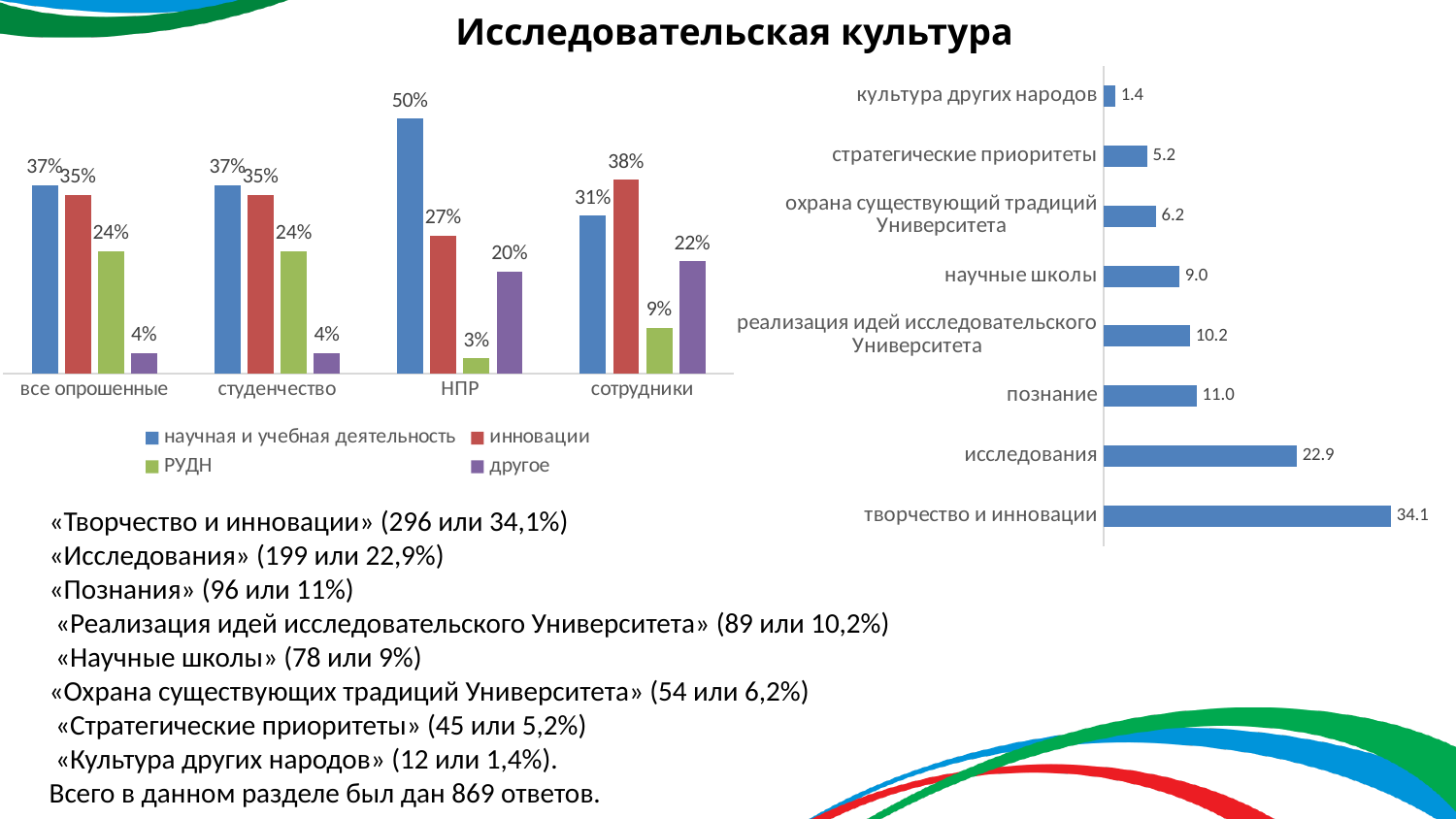
In the left chart, what is the difference between 'инновации' and 'РУДН' in the 'сотрудники' category? 29% In the right chart, what is the difference between 'творчество и инновации' and 'исследования'? 11.2 In the left chart, what is the value for 'инновации' in the 'НПР' category? 27% In the left chart, what is the value for 'научная и учебная деятельность' in the 'сотрудники' category? 31% What kind of chart is the left chart? bar chart In the right chart, what is the value for 'научные школы'? 9.0 In the right chart, which category has the highest value? творчество и инновации How many categories are shown in the right chart? 8 In the left chart, which category has the highest value for 'научная и учебная деятельность'? НПР In the left chart, which is larger in the 'НПР' category: 'инновации' or 'другое'? инновации How many series does the legend of the left chart list? 4 In the left chart, which category has the lowest value for 'РУДН'? НПР